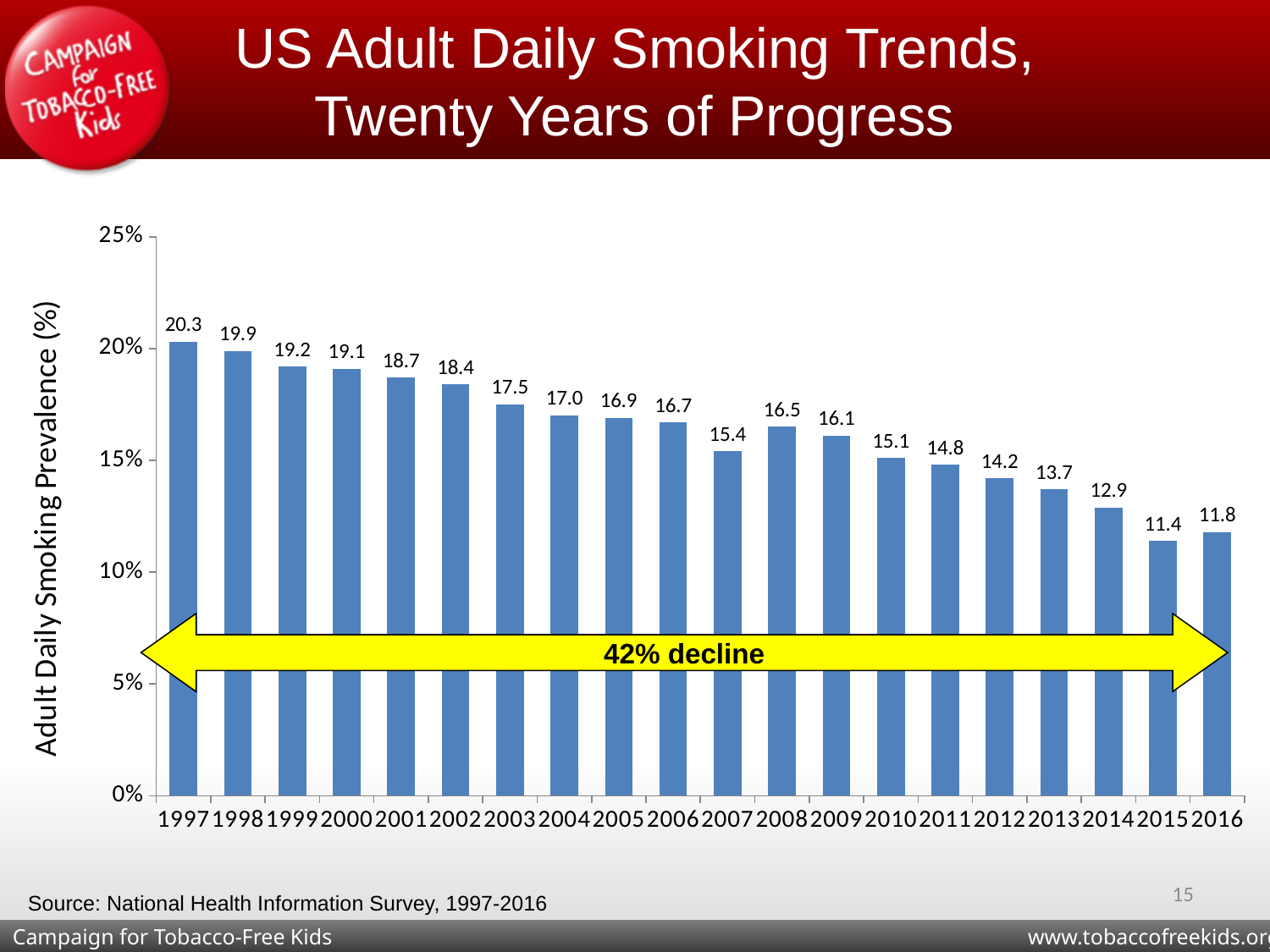
What is the value shown for 2007? 15.4 What is the adult daily smoking prevalence for 2016? 11.8 Is the value for 2013 greater or less than 15%? less Which year has the lowest adult daily smoking prevalence? 2015 Which year has a higher value, 2008 or 2009? 2008 What kind of chart is shown on the slide? bar chart Which year has the highest adult daily smoking prevalence? 1997 What is the difference between the values for 1997 and 2016? 8.5 What text is written inside the yellow arrow on the chart? 42% decline What is the adult daily smoking prevalence for 1997? 20.3 How many years are shown on the x axis? 20 Do the values generally rise or fall from 1997 to 2016? fall